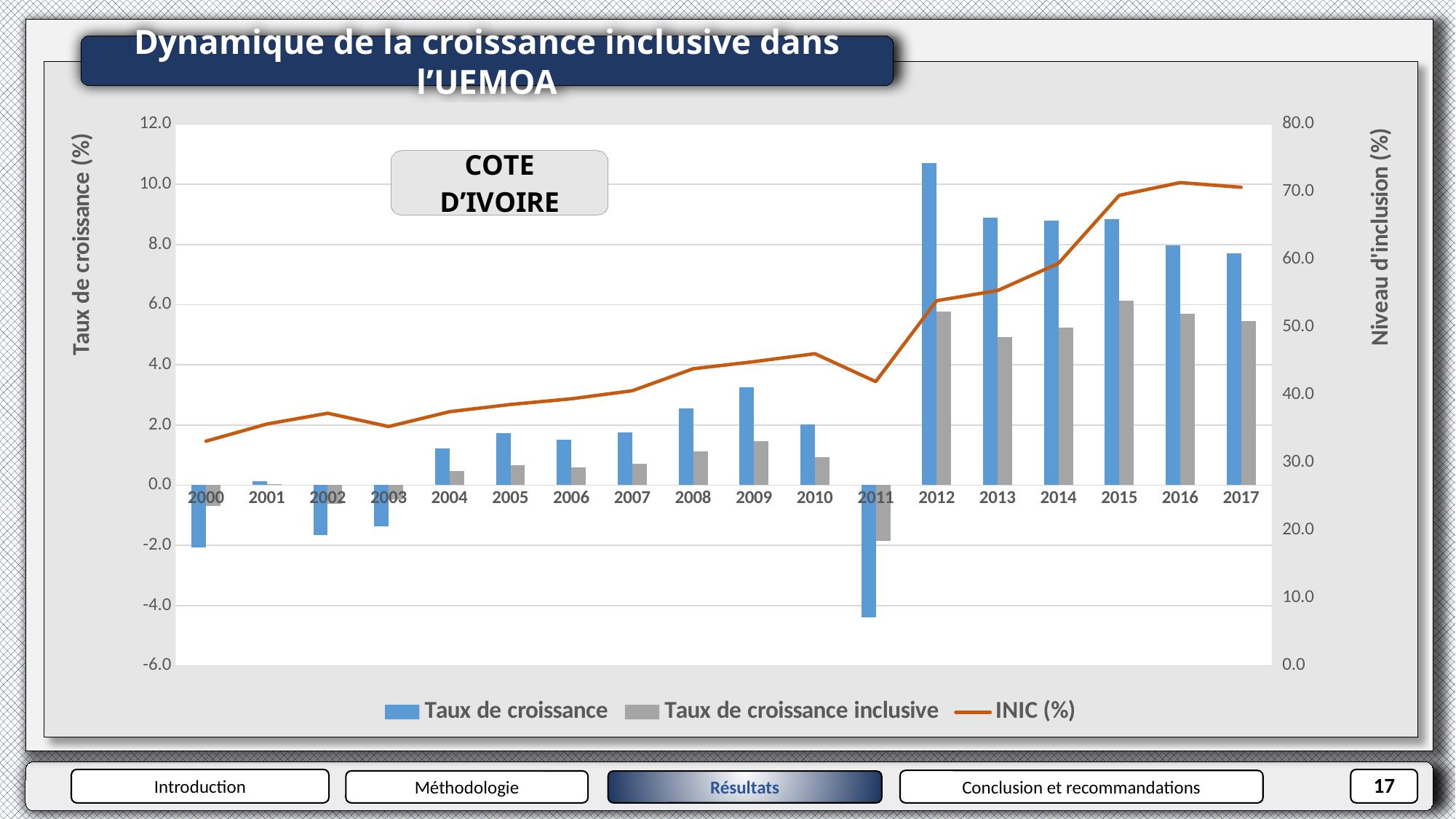
Which is larger, the Taux de croissance for 2009 or for 2010? 2009 How many series does the legend list? 3 Is the INIC (%) value for 2011 greater or less than 45.0? less Does the INIC (%) line rise or fall between 2012 and 2016? rise Is the Taux de croissance for 2011 greater or less than -4.0? less Which year has the highest Taux de croissance inclusive? 2015 Which country is named in the label box on the chart? COTE D'IVOIRE Is the Taux de croissance for 2012 greater or less than 10.0? greater Which year has the lowest Taux de croissance? 2011 Which year has the highest Taux de croissance? 2012 What kind of chart is shown on the slide? Combined bar and line chart How many years are shown on the x axis? 18